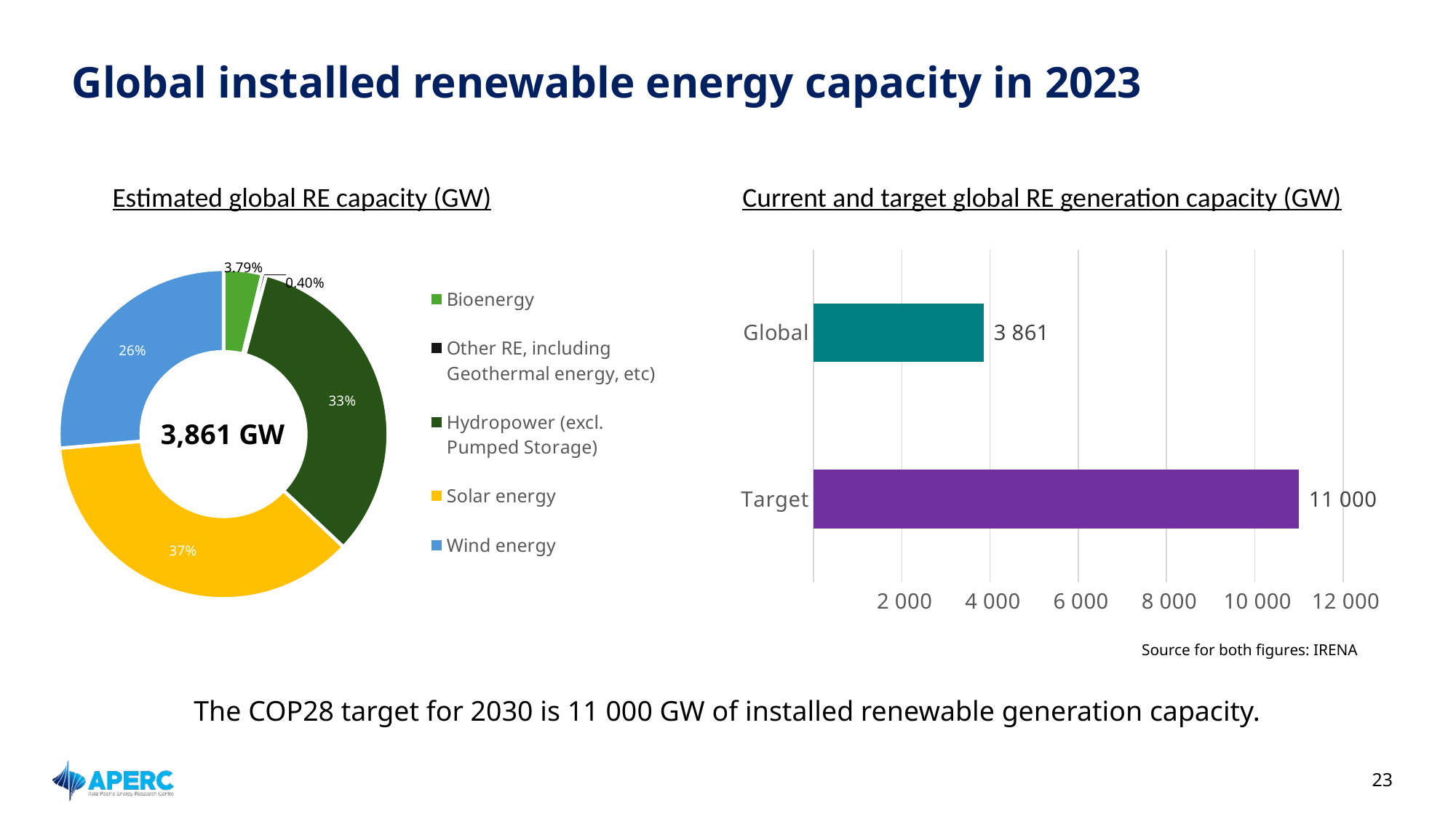
In the 'Estimated global RE capacity (GW)' chart, which category has the smallest share? Other RE, including Geothermal energy, etc) What kind of chart is the 'Current and target global RE generation capacity (GW)' chart? Bar chart In the 'Estimated global RE capacity (GW)' chart, what share of the donut does Solar energy account for? 37% In the 'Estimated global RE capacity (GW)' chart, what share does Wind energy account for? 26% In the 'Estimated global RE capacity (GW)' chart, how many categories does the legend list? 5 In the 'Estimated global RE capacity (GW)' chart, what total capacity is shown in the centre of the donut? 3,861 GW In the 'Current and target global RE generation capacity (GW)' chart, what is the value for Global? 3 861 In the 'Current and target global RE generation capacity (GW)' chart, what is the value for Target? 11 000 In the 'Estimated global RE capacity (GW)' chart, which category has the largest share? Solar energy In the 'Estimated global RE capacity (GW)' chart, what share does Hydropower (excl. Pumped Storage) account for? 33% In the 'Current and target global RE generation capacity (GW)' chart, what is the difference between the Target and Global values? 7 139